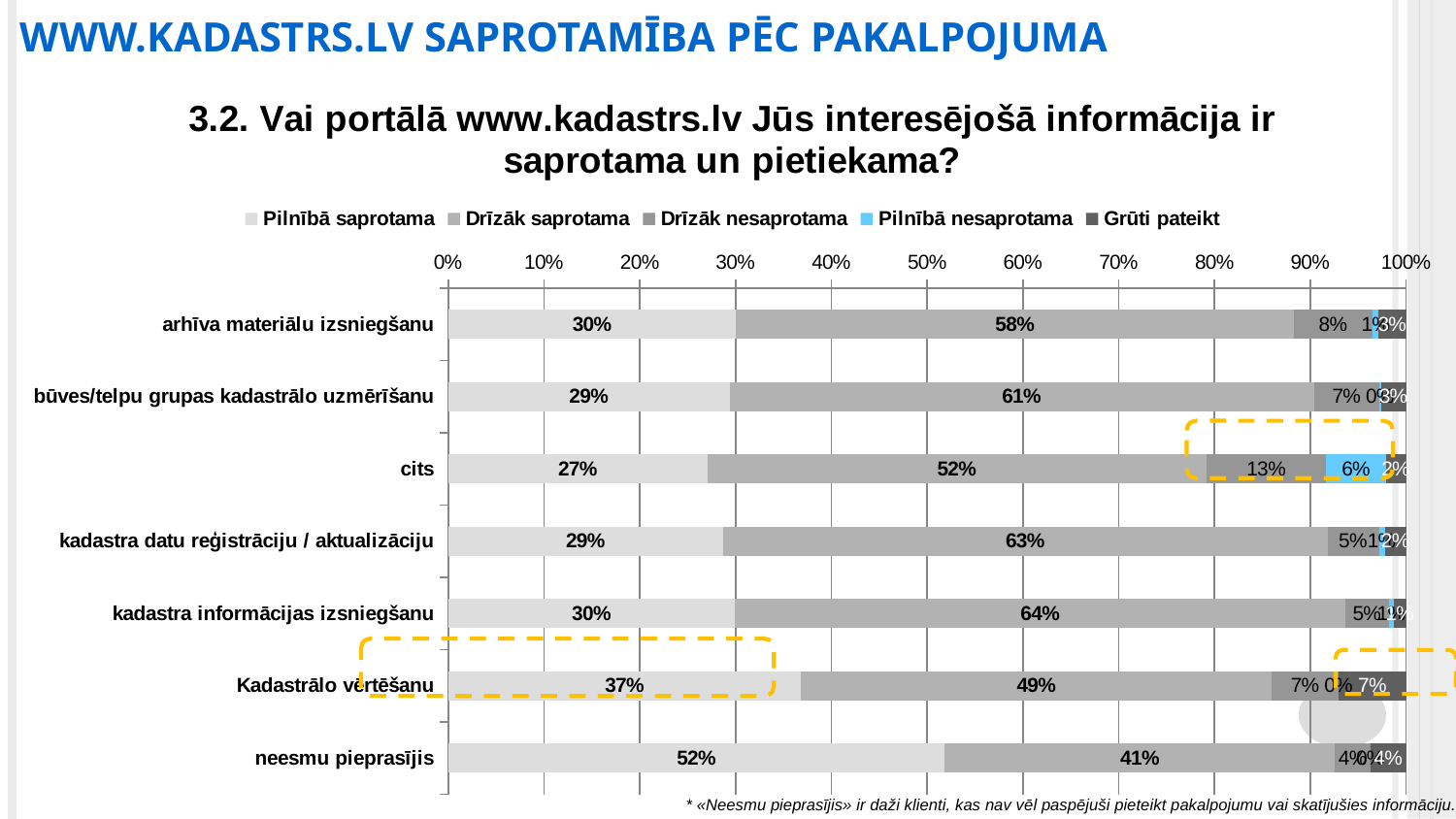
Which category has the highest 'Drīzāk saprotama' value? kadastra informācijas izsniegšanu How many categories are plotted on the chart? 7 How many series does the legend list? 5 What is the difference between the 'Pilnībā saprotama' values for 'Kadastrālo vērtēšanu' and 'arhīva materiālu izsniegšanu'? 7 percentage points What is the 'Drīzāk saprotama' value for 'kadastra informācijas izsniegšanu'? 64% What kind of chart is shown on the slide? bar chart Which has the larger 'Drīzāk saprotama' value: 'arhīva materiālu izsniegšanu' or 'cits'? arhīva materiālu izsniegšanu What is the 'Pilnībā saprotama' value for 'neesmu pieprasījis'? 52% What is the 'Drīzāk nesaprotama' value for 'cits'? 13% Which category has the highest 'Pilnībā saprotama' value? neesmu pieprasījis Which category has the lowest 'Pilnībā saprotama' value? cits What is the first entry in the chart legend? Pilnībā saprotama